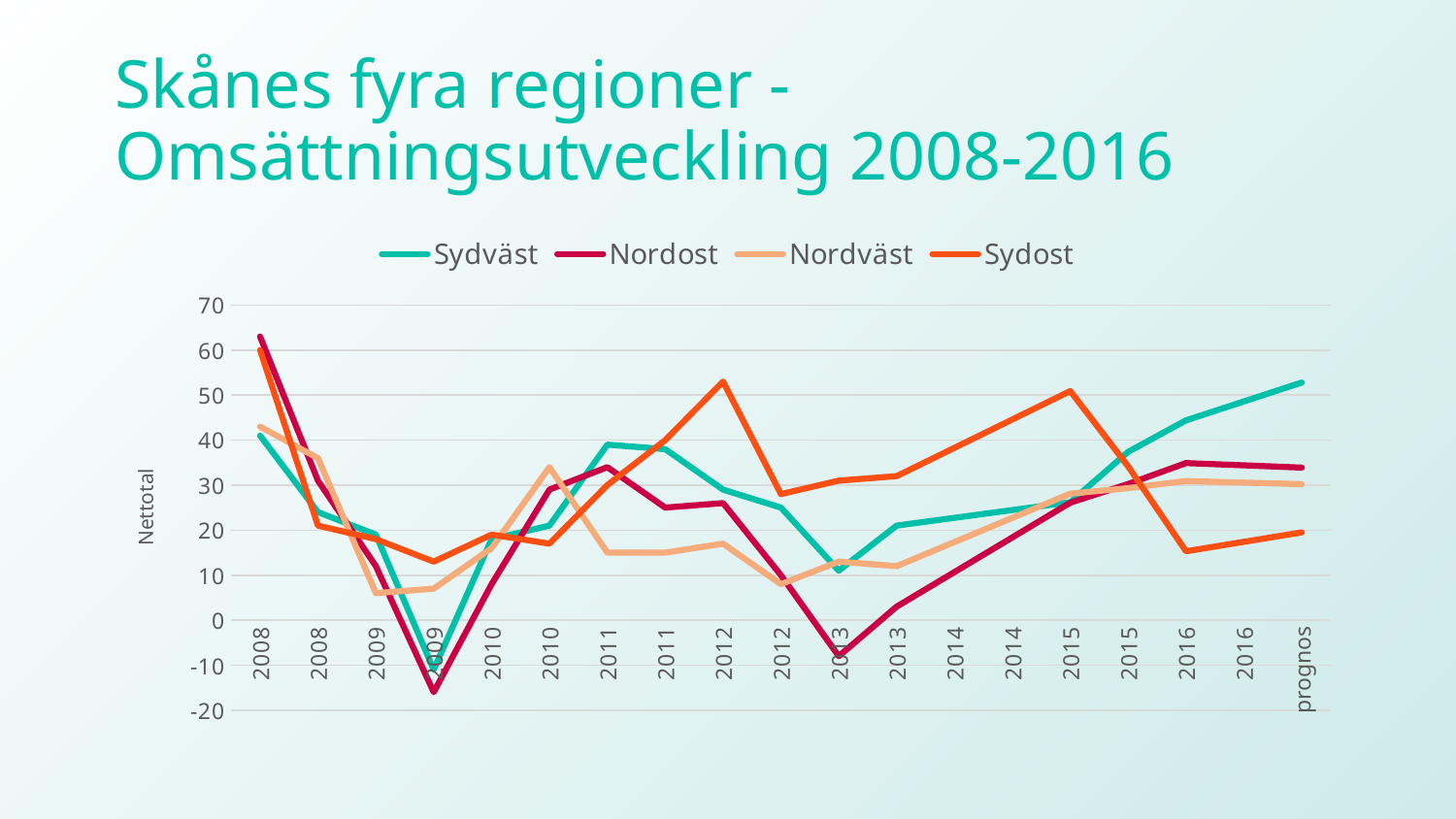
Does the Sydväst line rise or fall from the first 2014 point to the 'prognos' point? rise Which series has the lowest value at the 'prognos' point? Sydost Is the value for Nordost at the first 2013 point greater or less than 0? less Which series has the lowest value at the second 2009 point? Nordost How many points are there along the x axis? 19 Is the value for Nordost at the second 2009 point greater or less than -10? less At the first 2012 point, which is larger: Sydost or Nordväst? Sydost What is the label on the vertical axis? Nettotal Is the value for Sydost at the first 2015 point greater or less than 40? greater What type of chart is shown on the slide? line chart Which series has the highest value at the 'prognos' point? Sydväst How many series does the legend list? 4